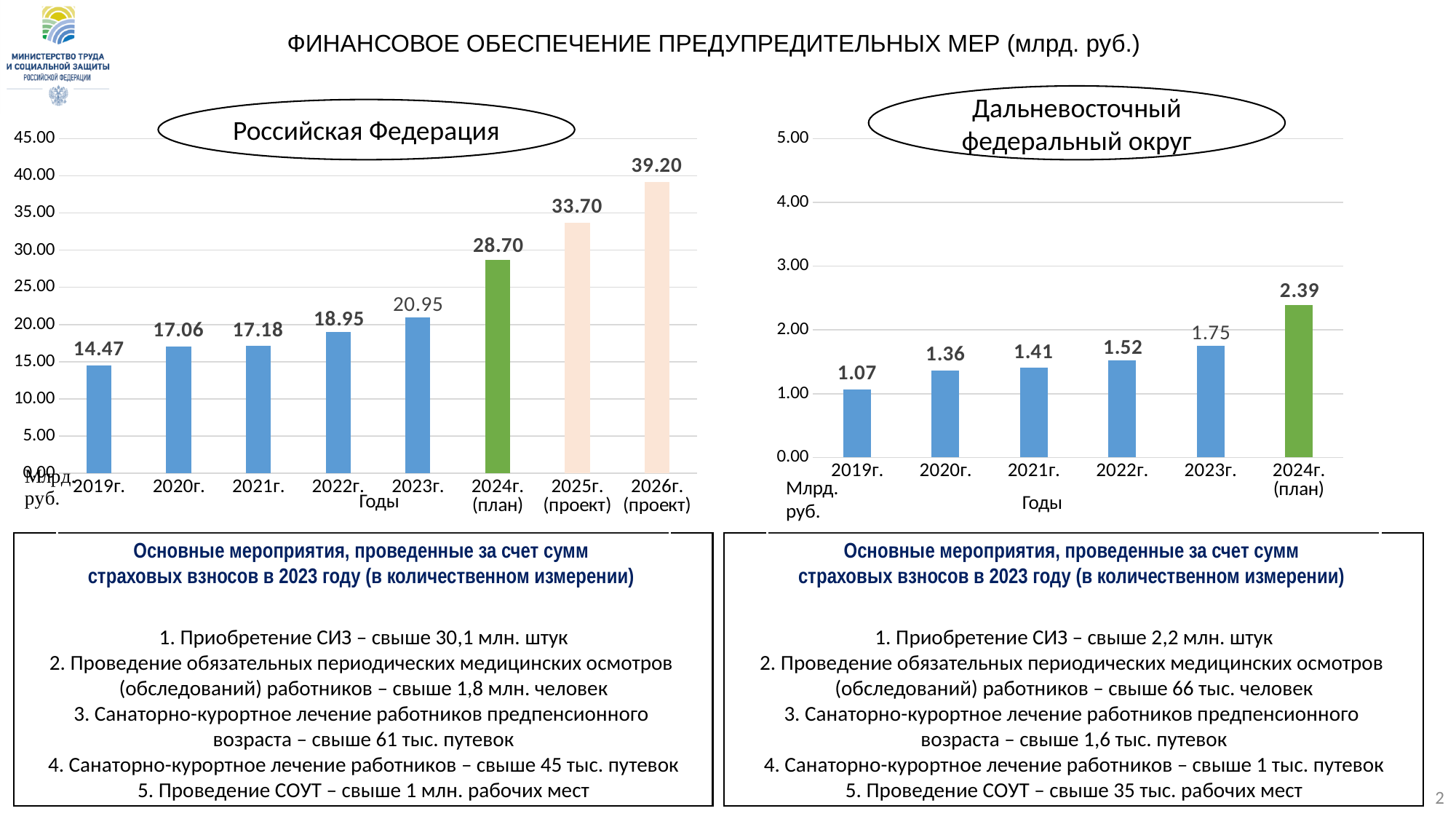
In the "Дальневосточный федеральный округ" chart, which year has the lowest value? 2019г. In the "Дальневосточный федеральный округ" chart, do the values rise or fall from 2019г. to 2024г. (план)? Rise How many bars are shown in the "Российская Федерация" chart? 8 In the "Дальневосточный федеральный округ" chart, what is the difference between the values for 2023г. and 2019г.? 0.68 In the "Дальневосточный федеральный округ" chart, what is the value for 2024г. (план)? 2.39 How many bars are shown in the "Дальневосточный федеральный округ" chart? 6 In the "Российская Федерация" chart, which is larger: the value for 2022г. or the value for 2020г.? 2022г. What type of chart is the "Дальневосточный федеральный округ" chart? Bar chart In the "Российская Федерация" chart, what is the value for 2026г. (проект)? 39.20 In the "Российская Федерация" chart, what is the value for 2023г.? 20.95 In the "Российская Федерация" chart, which year has the highest value? 2026г. (проект) In the "Российская Федерация" chart, what is the difference between the values for 2024г. (план) and 2023г.? 7.75